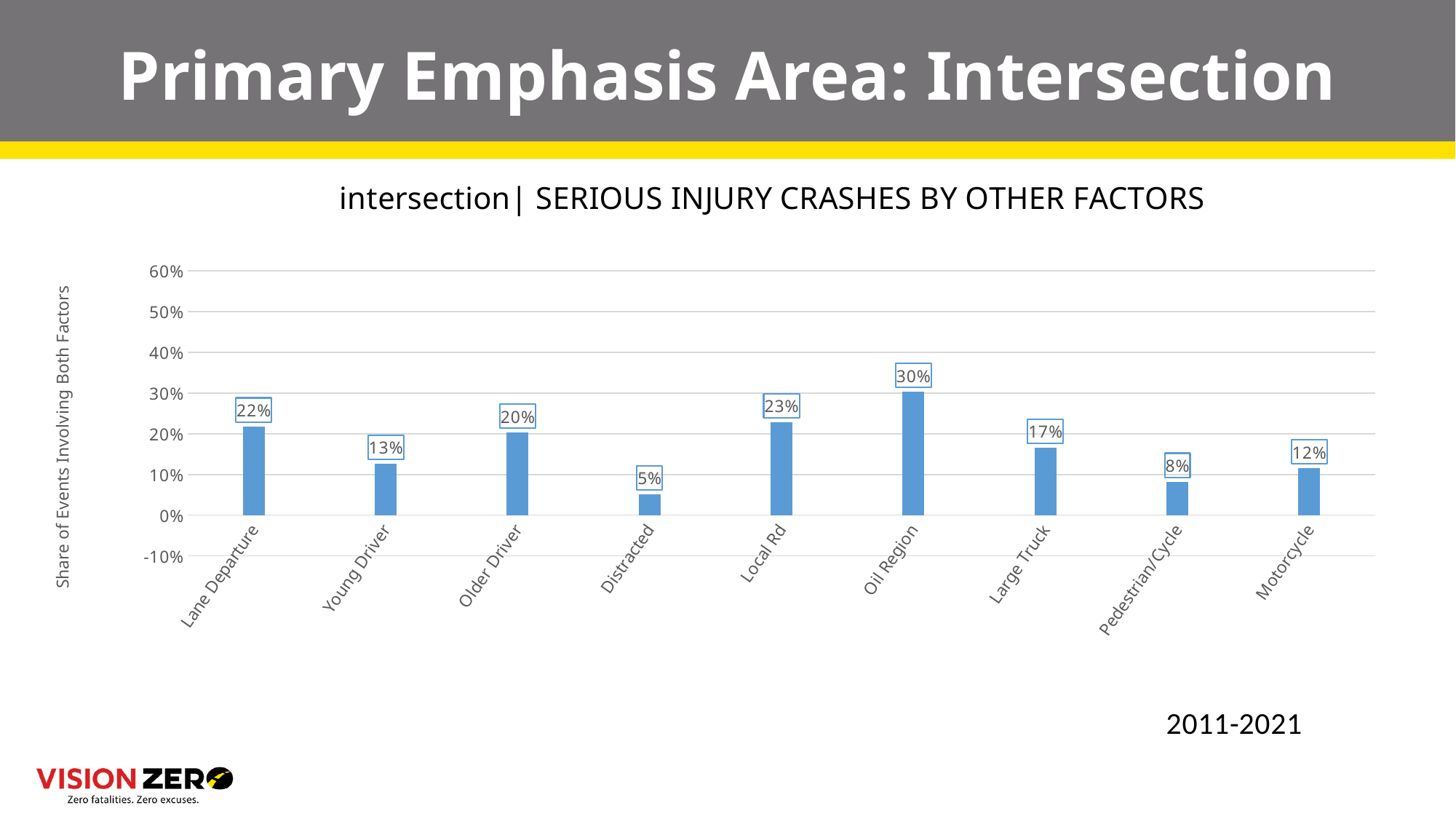
Which is larger, the value for Lane Departure or the value for Older Driver? Lane Departure What is the difference between the values for Oil Region and Local Rd? 7% Is the value for Large Truck greater or less than 20%? less What is the value for Oil Region? 30% Which category has the lowest value? Distracted What is the label of the vertical axis? Share of Events Involving Both Factors What kind of chart is shown on the slide? bar chart What is the value for Pedestrian/Cycle? 8% How many categories are shown on the x axis? 9 What is the title of the chart? intersection| SERIOUS INJURY CRASHES BY OTHER FACTORS Which category has the highest value? Oil Region What is the value for Distracted? 5%